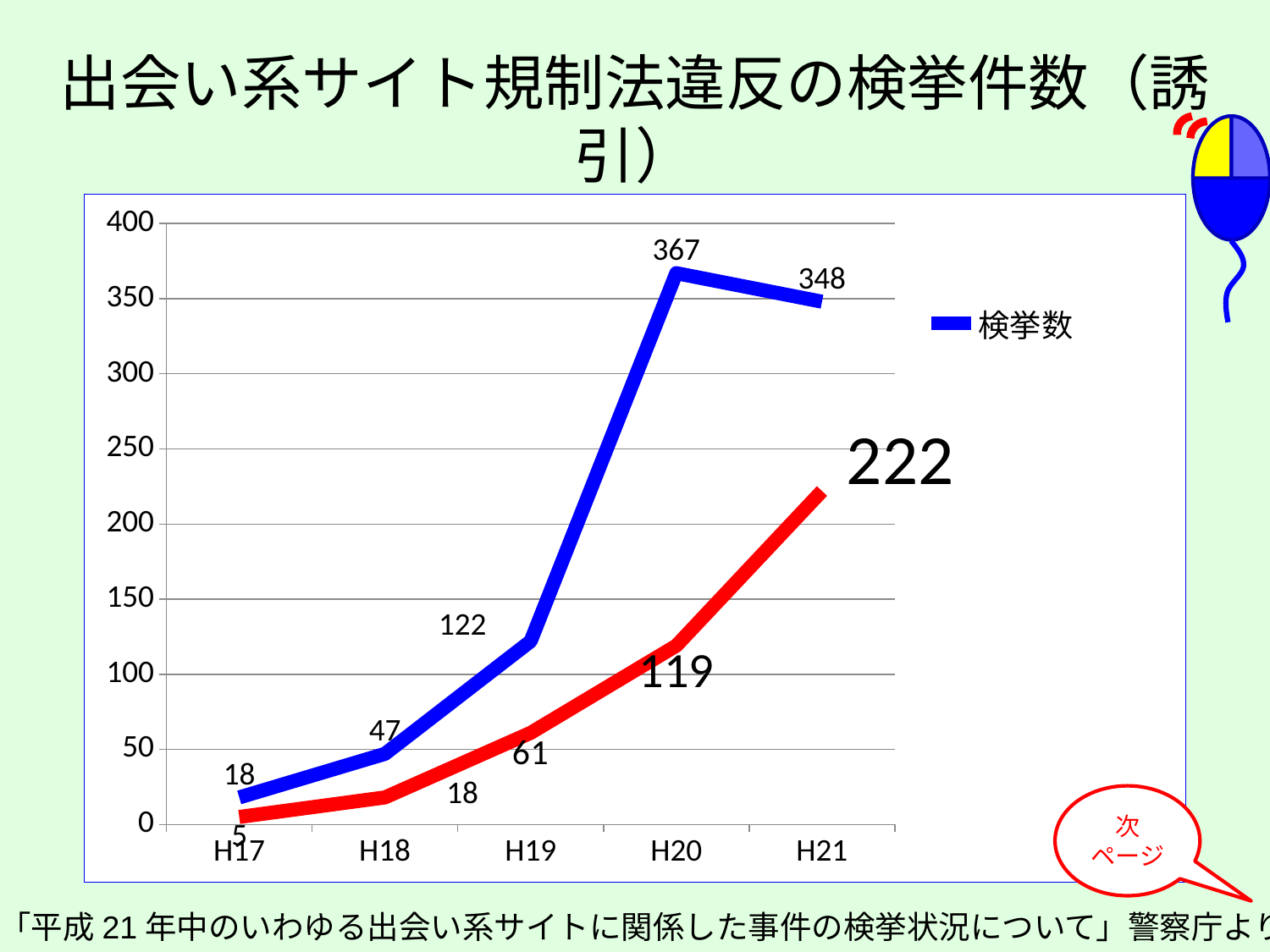
What is the value of the blue 検挙数 line for H18? 47 Does the red line rise or fall from H17 to H21? rise What is the difference between the blue 検挙数 values for H20 and H21? 19 What is the value of the red line for H19? 61 In which year does the blue 検挙数 line reach its highest value? H20 Which is larger for H19: the blue 検挙数 value or the red line value? the blue 検挙数 value How many years are shown on the x axis? 5 What type of chart is shown on the slide? line chart In which year is the red line at its lowest value? H17 What is the value of the blue 検挙数 line for H20? 367 What is the value of the red line for H21? 222 How many series does the legend list? 1